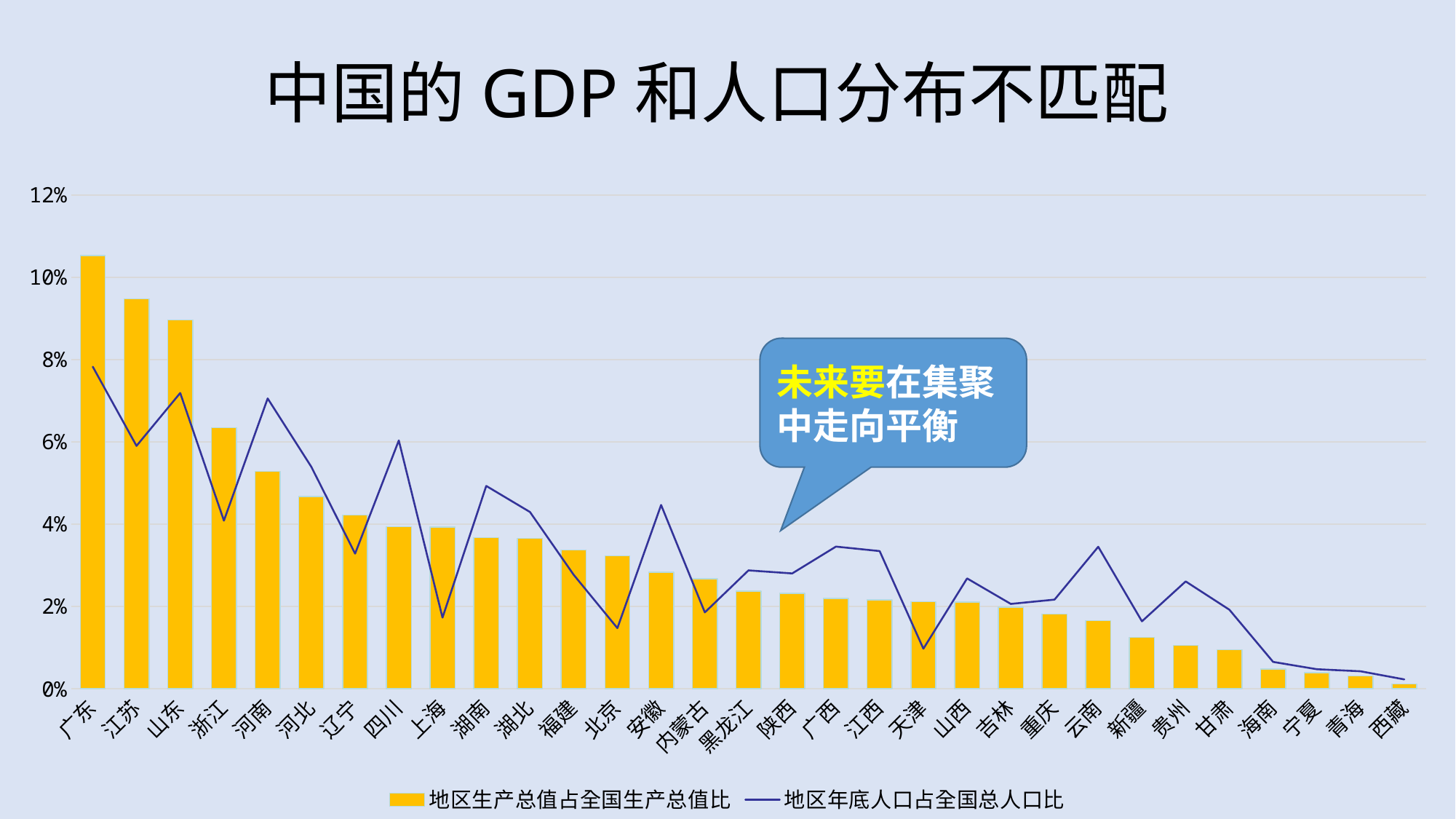
Is the 地区生产总值占全国生产总值比 bar for 广东 greater or less than 10%? greater Is the 地区年底人口占全国总人口比 line value for 河南 greater or less than 6%? greater How many provinces are shown on the x axis? 31 How many series does the legend list? 2 Which province has the lowest bar for 地区生产总值占全国生产总值比? 西藏 Do the 地区生产总值占全国生产总值比 bars rise or fall from left to right along the x axis? fall What kind of chart is shown on the slide? A bar chart combined with a line What is the title of the slide? 中国的 GDP 和人口分布不匹配 Which province has the highest bar for 地区生产总值占全国生产总值比? 广东 Is the 地区年底人口占全国总人口比 line value for 北京 greater or less than 2%? less Which has the larger 地区生产总值占全国生产总值比 bar, 浙江 or 河南? 浙江